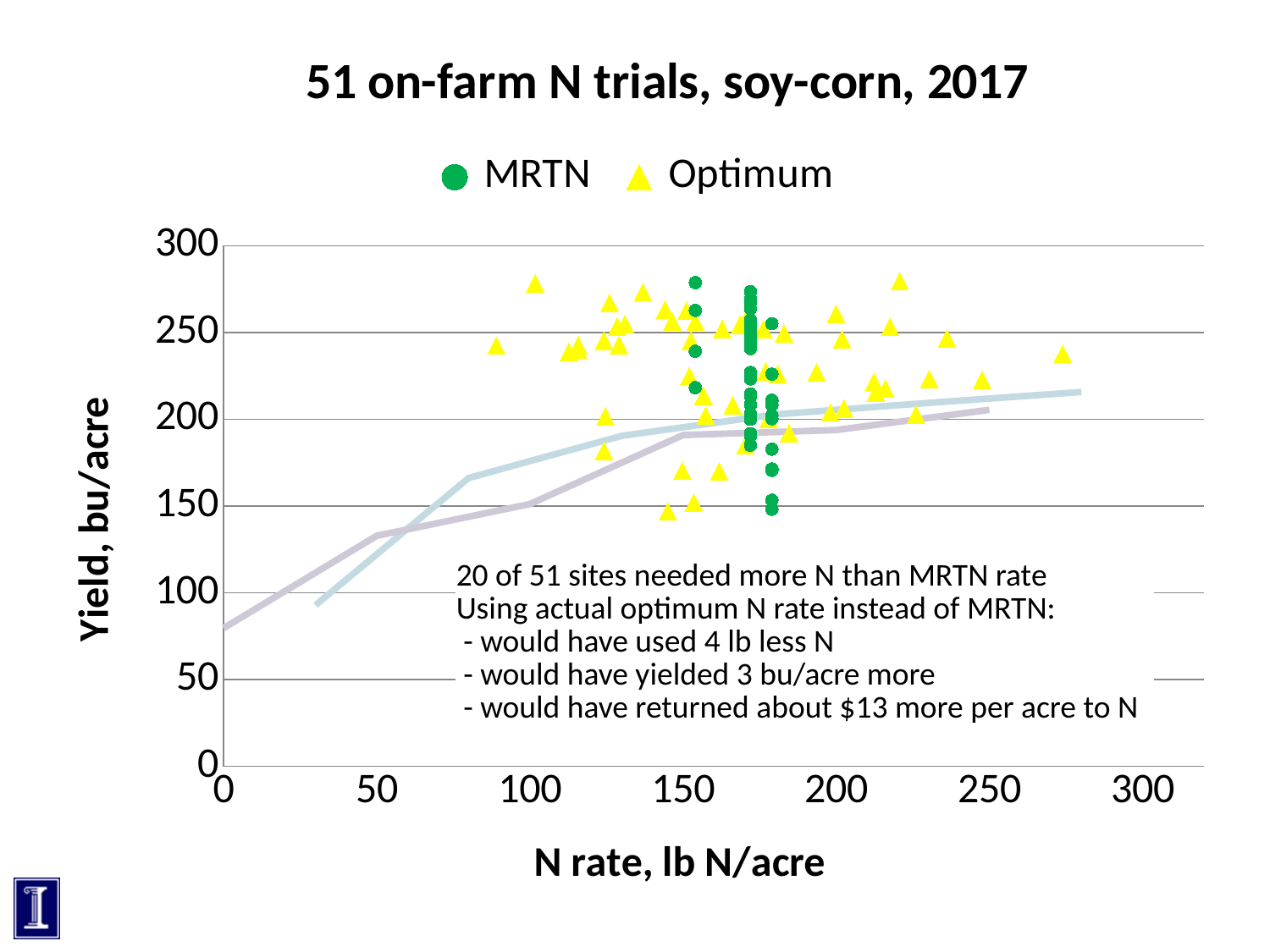
What is the maximum value shown on the y axis? 300 Is the highest Optimum yield plotted greater or less than 250? greater What is the label of the y axis? Yield, bu/acre What kind of chart is shown on the slide? Scatter chart What are the two series named in the legend? MRTN and Optimum What is the title of the chart? 51 on-farm N trials, soy-corn, 2017 How many series does the legend list? 2 Do the two fitted lines rise or fall as N rate increases along the x axis? rise According to the text on the chart, how many of the 51 sites needed more N than the MRTN rate? 20 What is the label of the x axis? N rate, lb N/acre Is the lowest MRTN yield plotted greater or less than 200? less Is the highest MRTN yield plotted greater or less than 250? greater